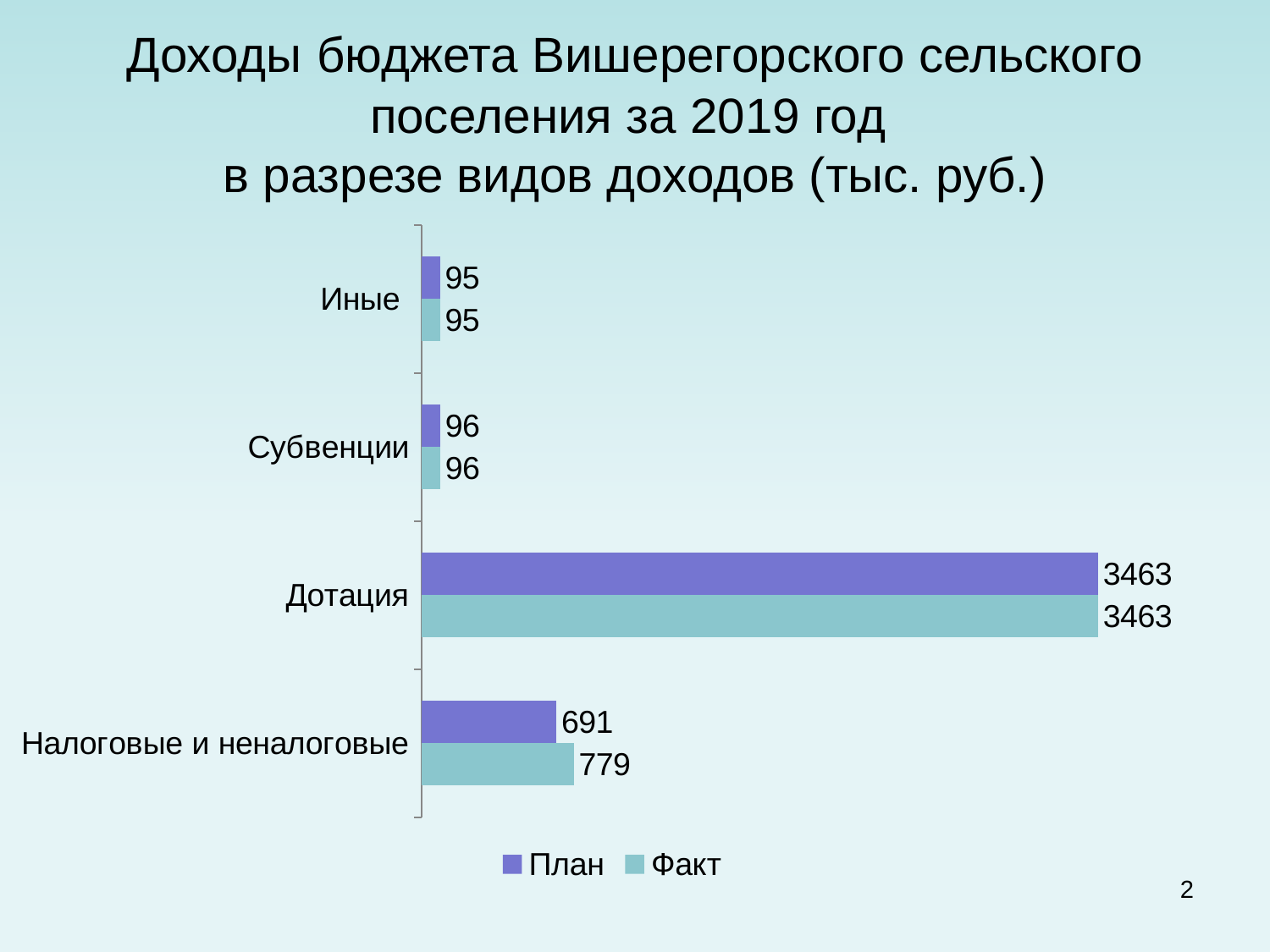
Which category has the lowest План value? Иные Which is larger for Налоговые и неналоговые: the План value or the Факт value? Факт What is the План value for Налоговые и неналоговые? 691 How many categories are shown on the chart? 4 What is the Факт value for Налоговые и неналоговые? 779 What is the Факт value for Субвенции? 96 Which category has the highest Факт value? Дотация What is the difference between the Факт and План values for Налоговые и неналоговые? 88 What is the План value for Иные? 95 What kind of chart is shown on the slide? Bar chart What is the План value for Дотация? 3463 How many series does the legend list? 2